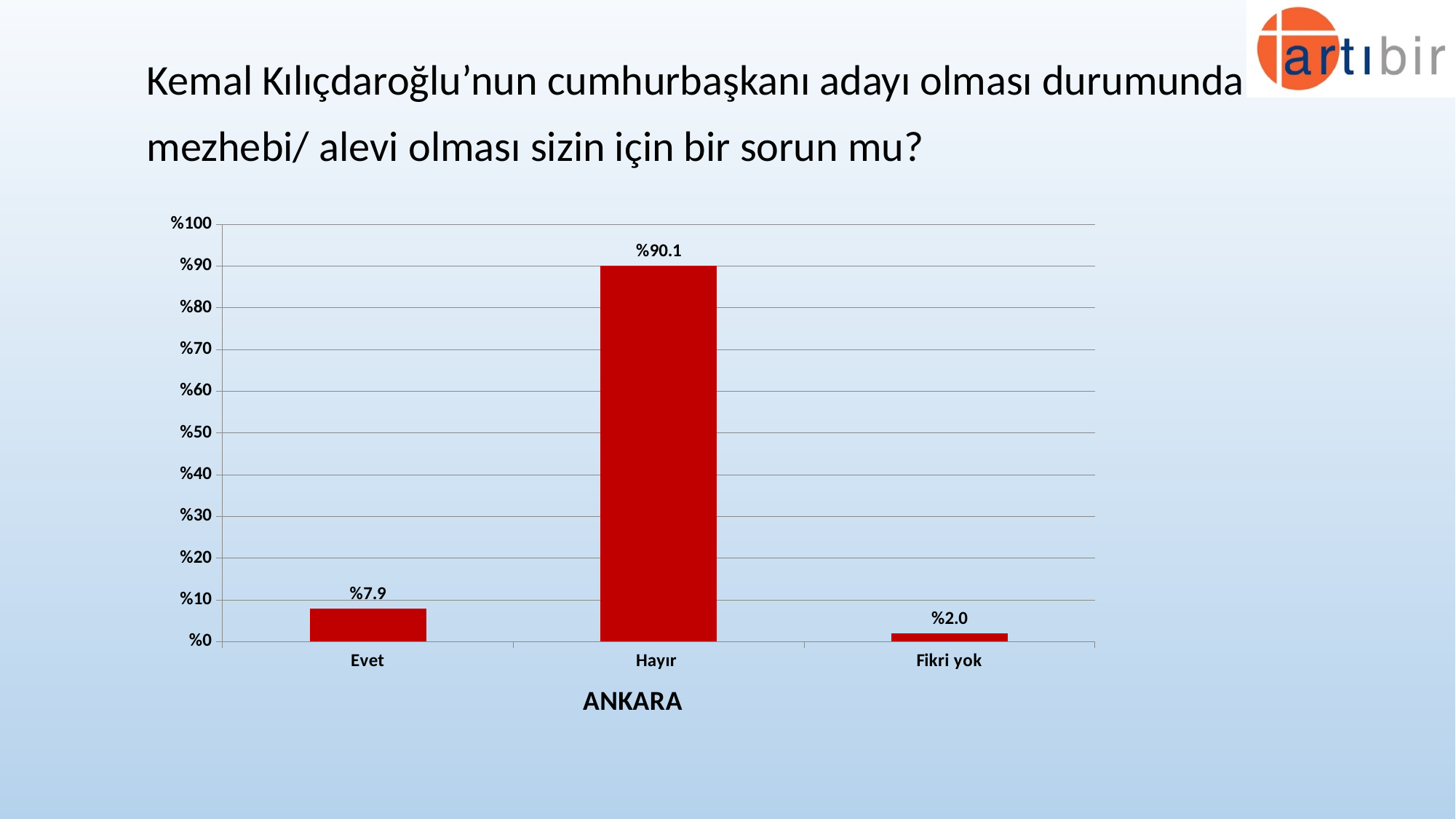
What is the difference between the values for Hayır and Evet? %82.2 What is the value for Evet? %7.9 How many categories are shown on the x axis? 3 What label appears below the x axis of the chart? ANKARA What is the value for Fikri yok? %2.0 What is the value for Hayır? %90.1 Which is larger, the value for Evet or the value for Fikri yok? Evet Is the value for Hayır greater or less than %80? greater What kind of chart is shown on the slide? bar chart What is the difference between the values for Evet and Fikri yok? %5.9 Which category has the highest value? Hayır Which category has the lowest value? Fikri yok